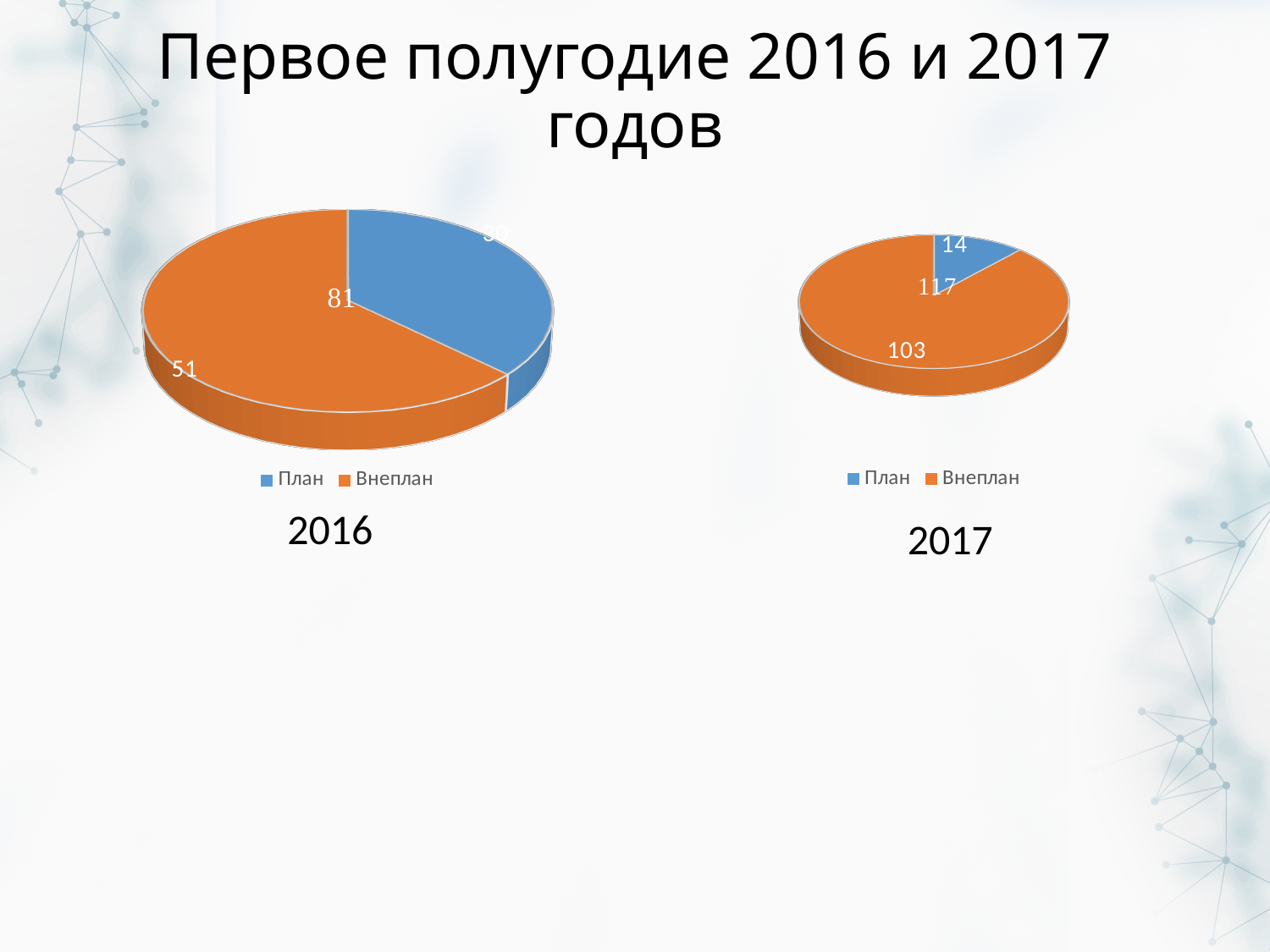
In the 2017 chart, what is the difference between the Внеплан value and the План value? 89 What kind of chart is the 2016 chart on the left of the slide? Pie chart What total is printed in the centre of the 2016 chart? 81 In the 2016 chart, which slice is the largest? Внеплан In the 2017 chart, which slice is larger, План or Внеплан? Внеплан In the 2016 chart, what is the value for Внеплан? 51 How many slices does the 2016 pie chart have? 2 In the 2017 chart, what is the value for План? 14 Which chart has the larger Внеплан value, the 2016 chart or the 2017 chart? 2017 What total is printed in the centre of the 2017 chart? 117 In the 2017 chart, what is the value for Внеплан? 103 How many series does the legend of the 2017 chart list? 2